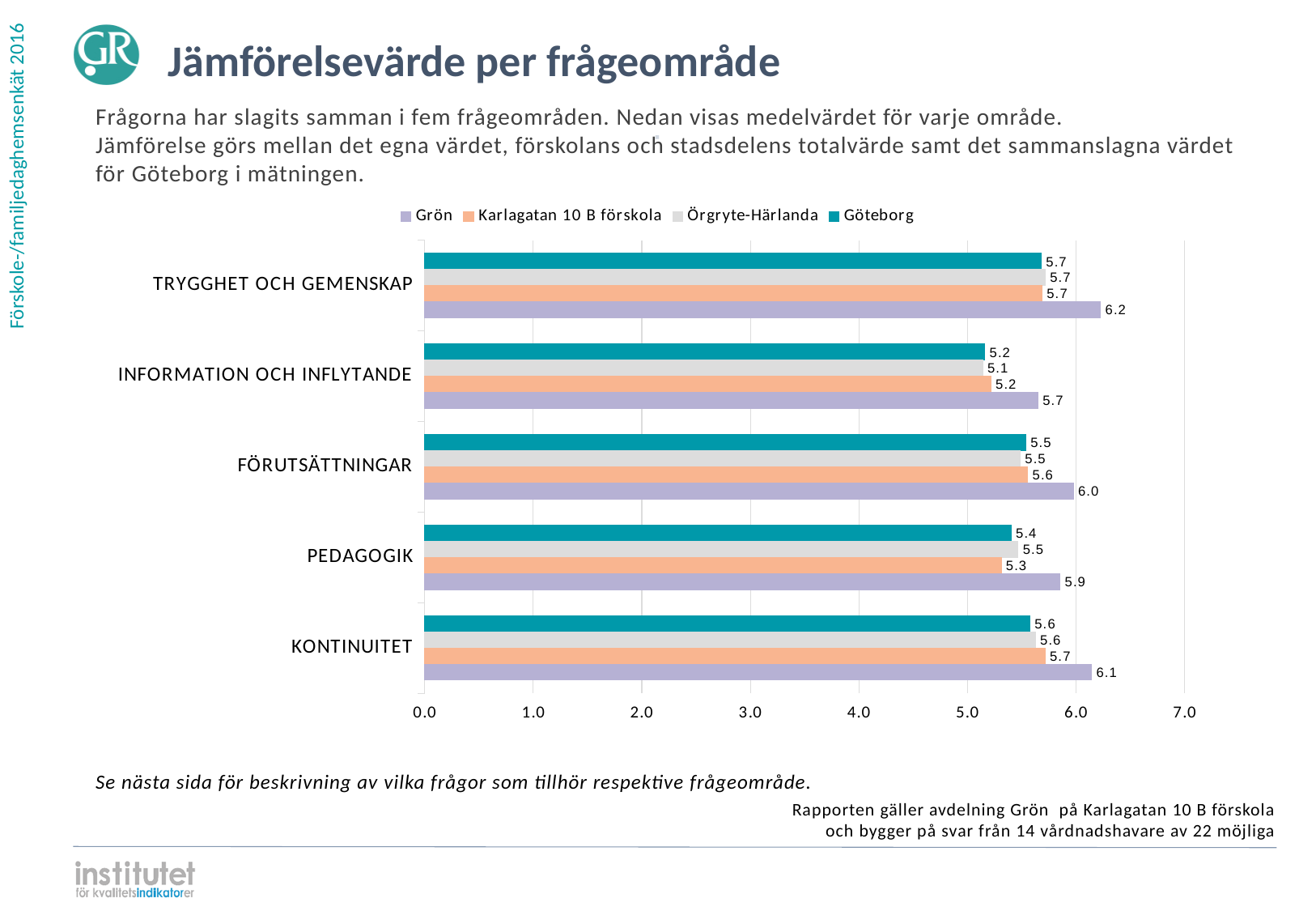
What kind of chart is shown on the slide? Bar chart What is the difference between the Grön value and the Göteborg value in the FÖRUTSÄTTNINGAR category? 0.5 In which category does Grön have its lowest value? INFORMATION OCH INFLYTANDE Is the value for Grön in the KONTINUITET category greater or less than 6.0? greater What is the value for Karlagatan 10 B förskola in the PEDAGOGIK category? 5.3 What is the value for Grön in the TRYGGHET OCH GEMENSKAP category? 6.2 How many question areas (categories) are shown on the chart? 5 In the PEDAGOGIK category, which is larger: the value for Grön or the value for Göteborg? Grön What is the value for Göteborg in the INFORMATION OCH INFLYTANDE category? 5.2 How many series does the legend list? 4 What is the value for Örgryte-Härlanda in the KONTINUITET category? 5.6 In which category does Grön have its highest value? TRYGGHET OCH GEMENSKAP